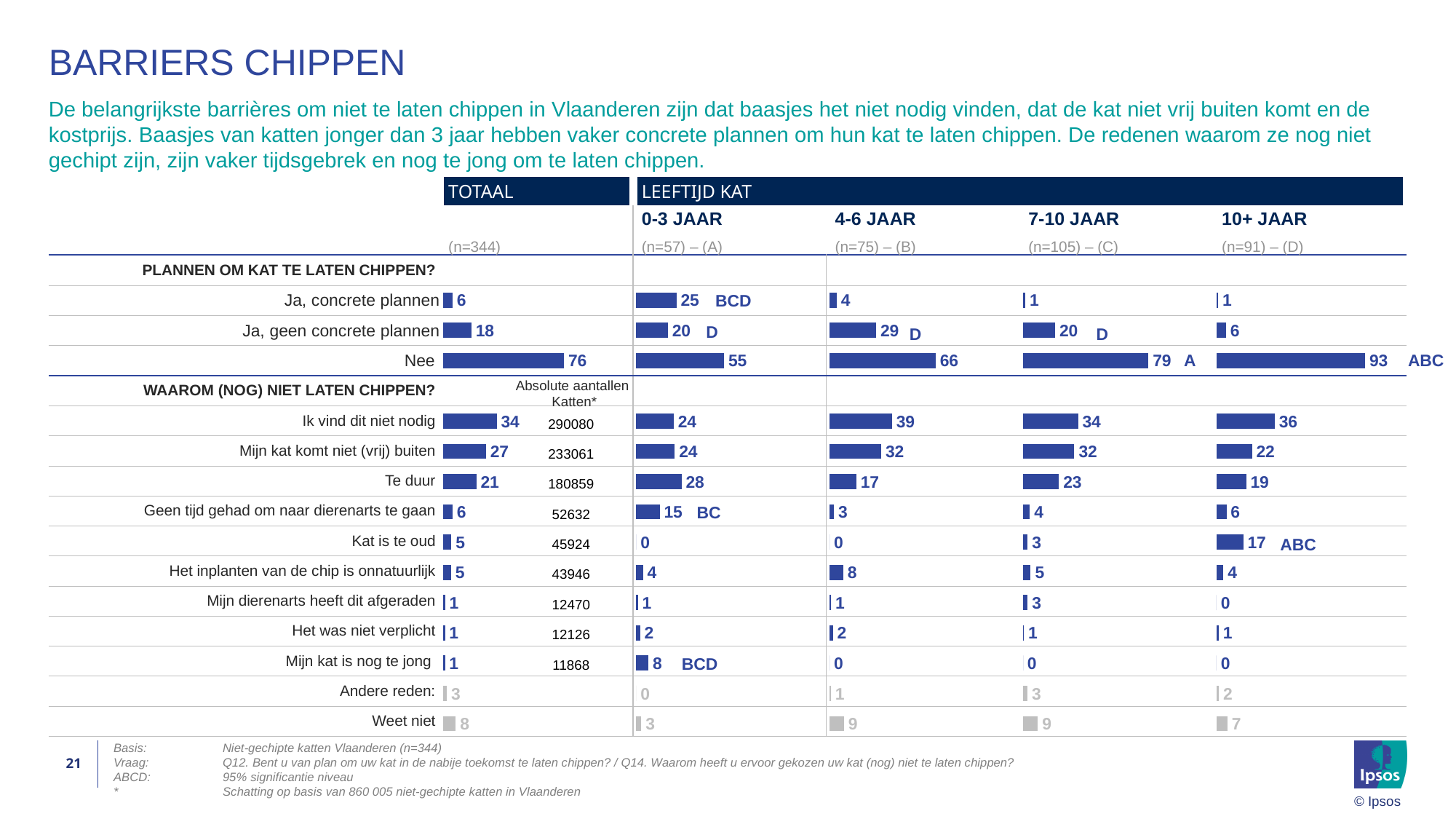
In the 0-3 JAAR column, what is the value for "Ja, concrete plannen"? 25 In the TOTAAL column, which reason under "Waarom (nog) niet laten chippen?" has the highest value? Ik vind dit niet nodig How many reasons are listed under "Waarom (nog) niet laten chippen?"? 11 Which is larger: the value for "Te duur" in the 0-3 JAAR column or in the 4-6 JAAR column? 0-3 JAAR What is the difference between the "Nee" values for 10+ JAAR and 0-3 JAAR? 38 In the 10+ JAAR column, what is the value for "Kat is te oud"? 17 What type of chart is used to show the values in the TOTAAL column? Bar chart In the TOTAAL column, what is the value for "Nee" under "Plannen om kat te laten chippen?"? 76 In the 0-3 JAAR column, which of the three answers under "Plannen om kat te laten chippen?" has the lowest value? Ja, geen concrete plannen In the TOTAAL column, what is the difference between "Ik vind dit niet nodig" and "Te duur"? 13 In the 4-6 JAAR column, what is the value for "Ik vind dit niet nodig"? 39 Across the four age-group columns, which age group has the highest value for "Nee"? 10+ JAAR